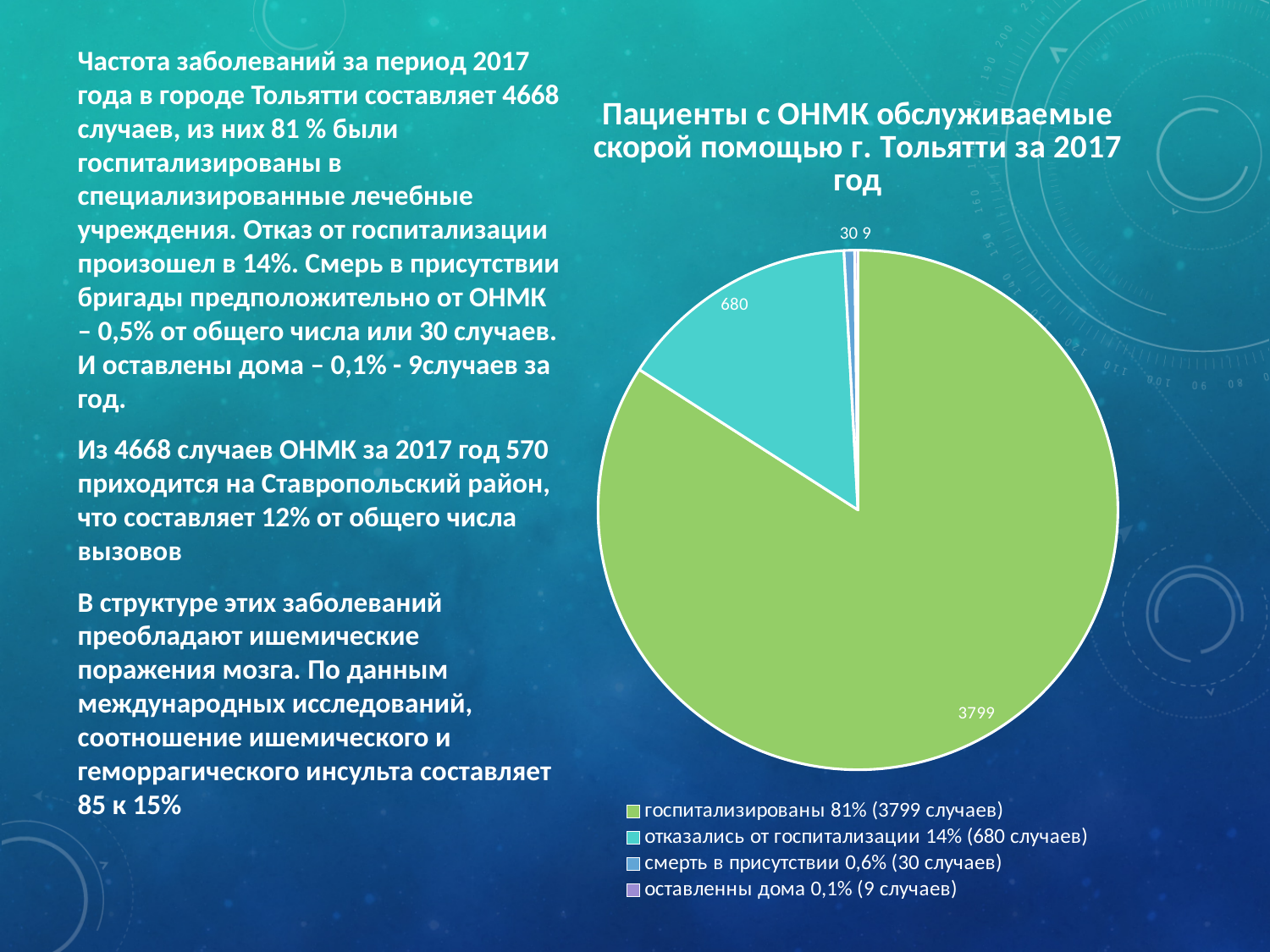
What kind of chart is shown on the slide? pie chart What is the value shown for the 'смерть в присутствии' slice? 30 How many slices does the pie chart have? 4 Which category has the largest slice in the pie chart? госпитализированы How many entries does the legend of the pie chart list? 4 Which category has the smallest slice in the pie chart? оставленны дома What is the value shown for the 'госпитализированы' slice? 3799 What share of the pie does 'отказались от госпитализации' represent, according to the legend? 14% What is the title of the pie chart? Пациенты с ОНМК обслуживаемые скорой помощью г. Тольятти за 2017 год What is the value shown for the 'отказались от госпитализации' slice? 680 What is the difference between the 'госпитализированы' value and the 'отказались от госпитализации' value? 3119 Which is larger: the 'смерть в присутствии' slice or the 'оставленны дома' slice? смерть в присутствии